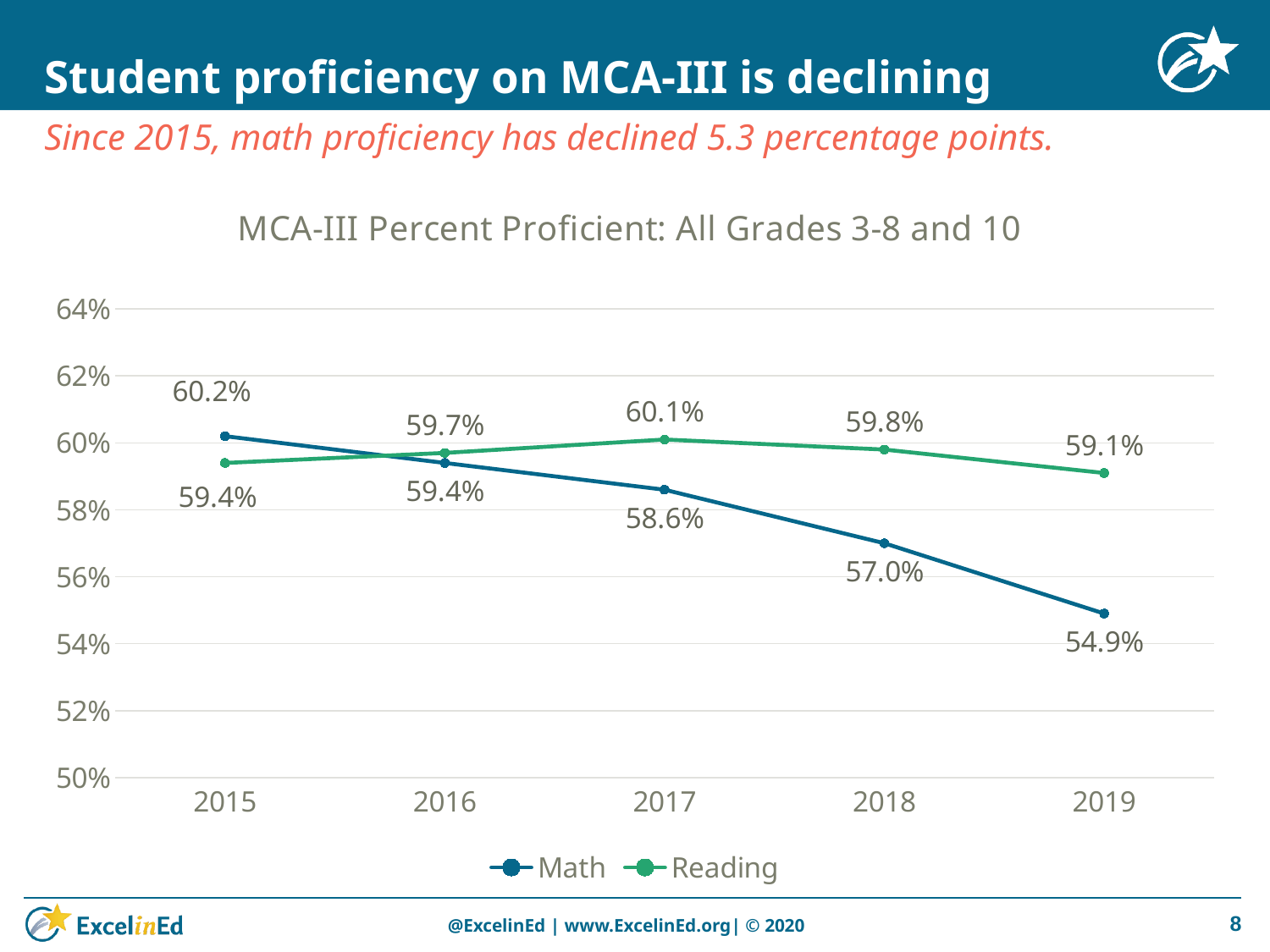
What is the title of the chart? MCA-III Percent Proficient: All Grades 3-8 and 10 How many years are shown on the x axis? 5 What is the Math proficiency value for 2019? 54.9% In which year is the Reading series at its highest? 2017 What is the Reading proficiency value for 2017? 60.1% Is the Math value for 2018 greater or less than 58%? less In which year is the Math series at its lowest? 2019 In 2018, which series has the higher value, Math or Reading? Reading How many series does the legend list? 2 Does the Math series rise or fall from 2015 to 2019? fall What kind of chart is shown on the slide? line chart By how many percentage points did Math proficiency fall from 2015 to 2019? 5.3 percentage points